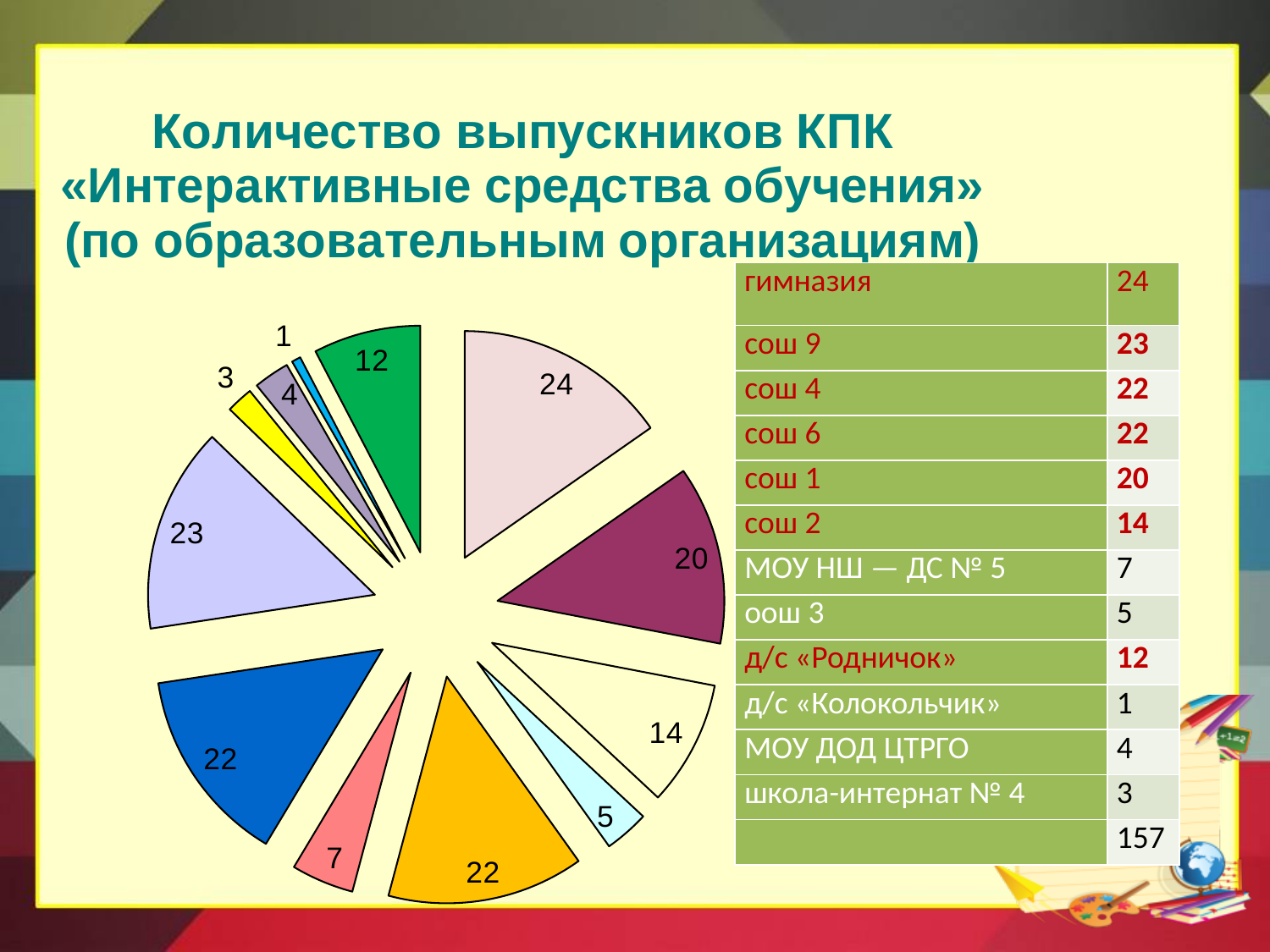
How many slices of the pie chart are labelled 22? 2 What is the value for сош 1 in the table accompanying the pie chart? 20 Which is larger: the slice labelled 14 or the slice labelled 7? 14 What is the value for д/с «Родничок» in the table accompanying the pie chart? 12 What kind of chart is shown on the slide? pie chart How many slices does the pie chart have? 12 What is the total of all values shown in the table next to the pie chart? 157 According to the table next to the pie chart, which organisation has the smallest number of graduates? д/с «Колокольчик» According to the table next to the pie chart, which organisation has the largest number of graduates? гимназия What is the difference between the largest slice (24) and the slice labelled 20? 4 What is the largest value labelled on the pie chart? 24 What is the smallest value labelled on the pie chart? 1